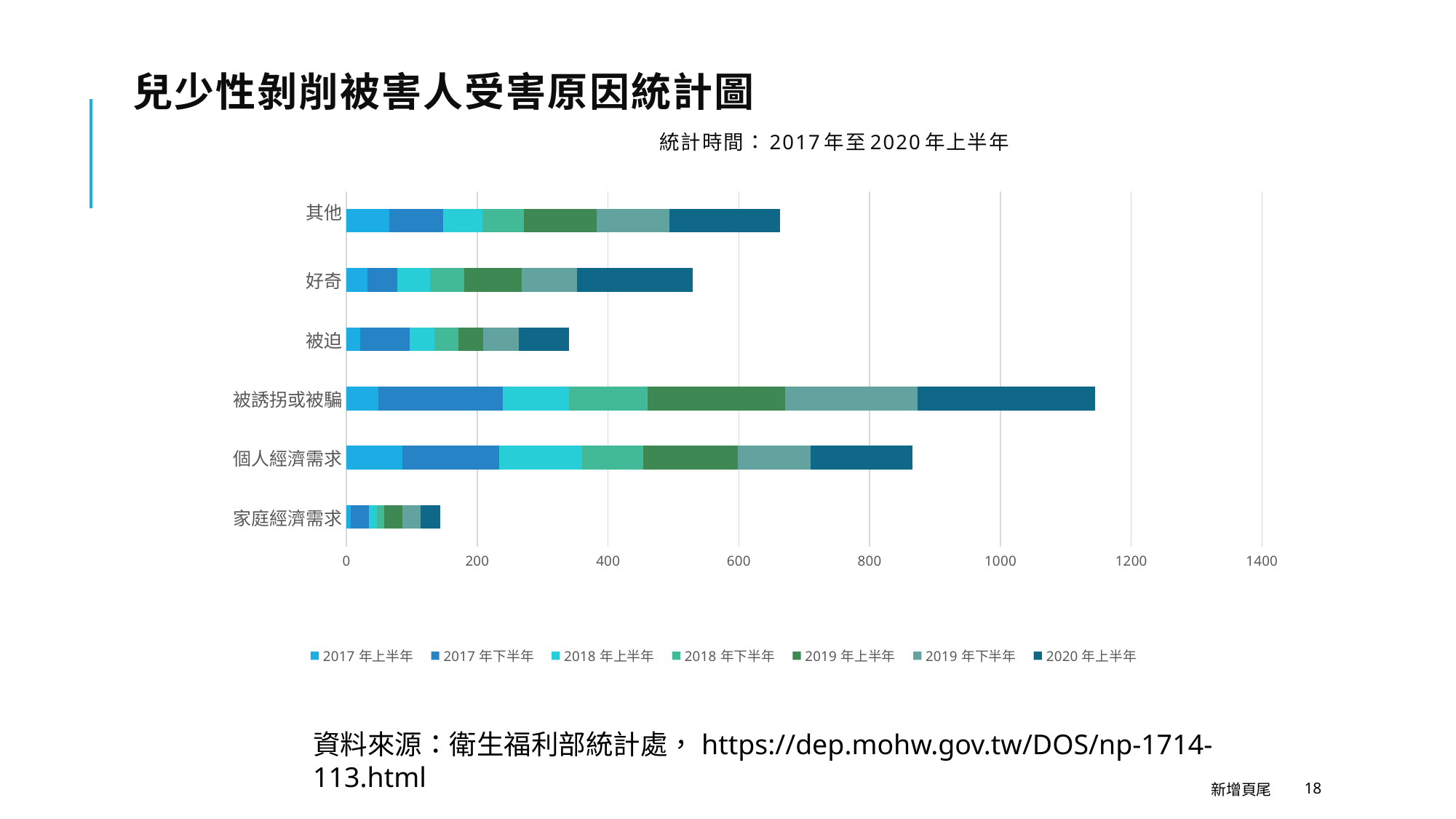
Is the total bar length for 家庭經濟需求 greater or less than 200? less Is the total bar length for 個人經濟需求 greater or less than 800? greater Which category has the longest total bar? 被誘拐或被騙 Is the total bar length for 被迫 greater or less than 400? less What kind of chart is shown on the slide? stacked bar chart How many series does the legend list? 7 Which has the longer total bar, 其他 or 好奇? 其他 What is the last series listed in the legend? 2020 年上半年 What is the title of the chart on the slide? 兒少性剝削被害人受害原因統計圖 How many categories (受害原因) are shown on the y axis of the chart? 6 Which category has the shortest total bar? 家庭經濟需求